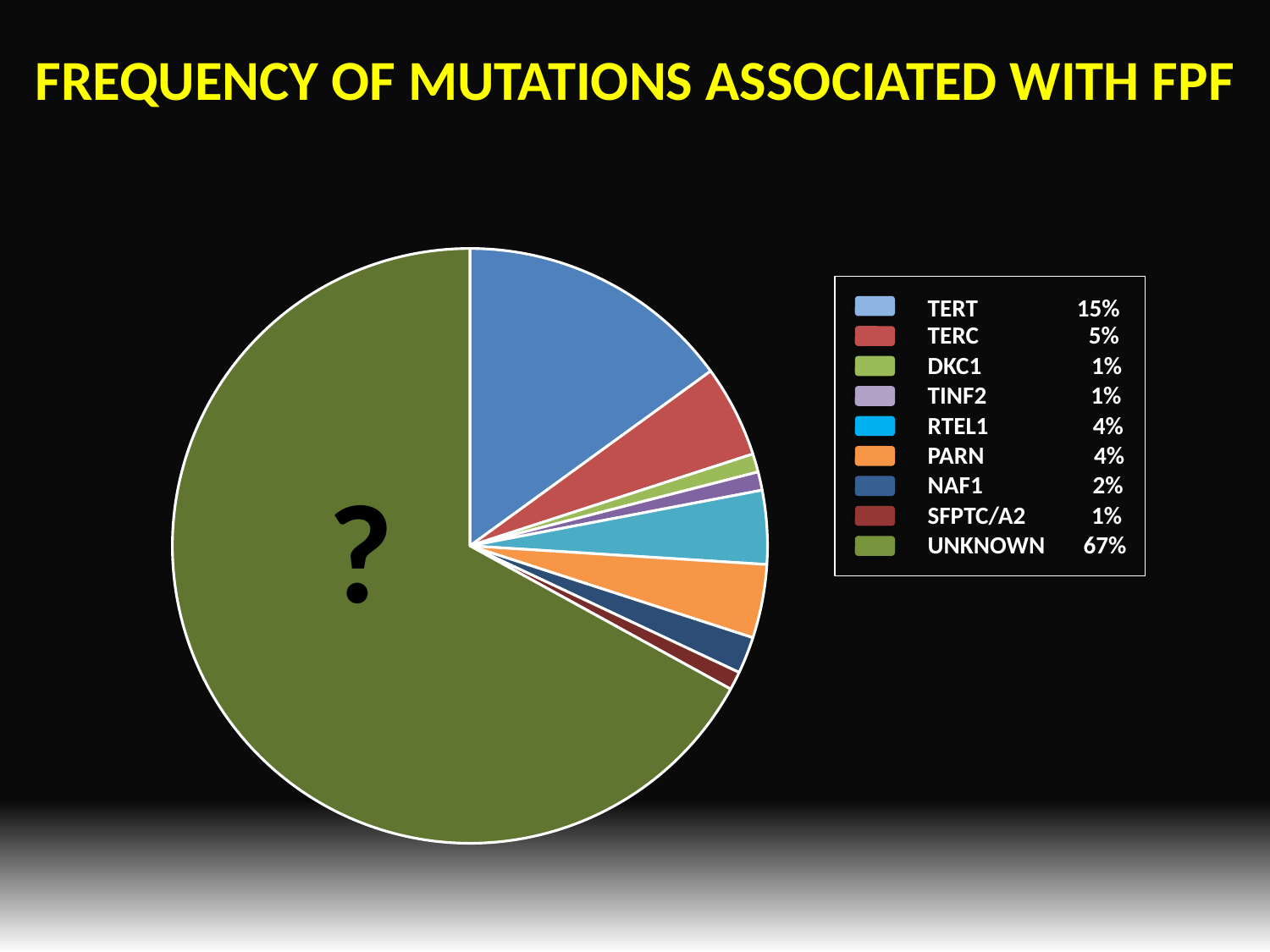
What is the difference in percentage between UNKNOWN and TERT? 52% What percentage is shown for TERT? 15% Which category has the largest share among the named mutations (excluding UNKNOWN)? TERT What percentage is shown for NAF1? 2% What is the title of the chart? FREQUENCY OF MUTATIONS ASSOCIATED WITH FPF What is the difference in percentage between TERT and TERC? 10% What percentage is shown for RTEL1? 4% How many categories does the legend list? 9 Which is larger, the share for TERC or the share for PARN? TERC What percentage is shown for UNKNOWN? 67% What kind of chart is shown on the slide? pie chart Which category has the largest share of the pie? UNKNOWN